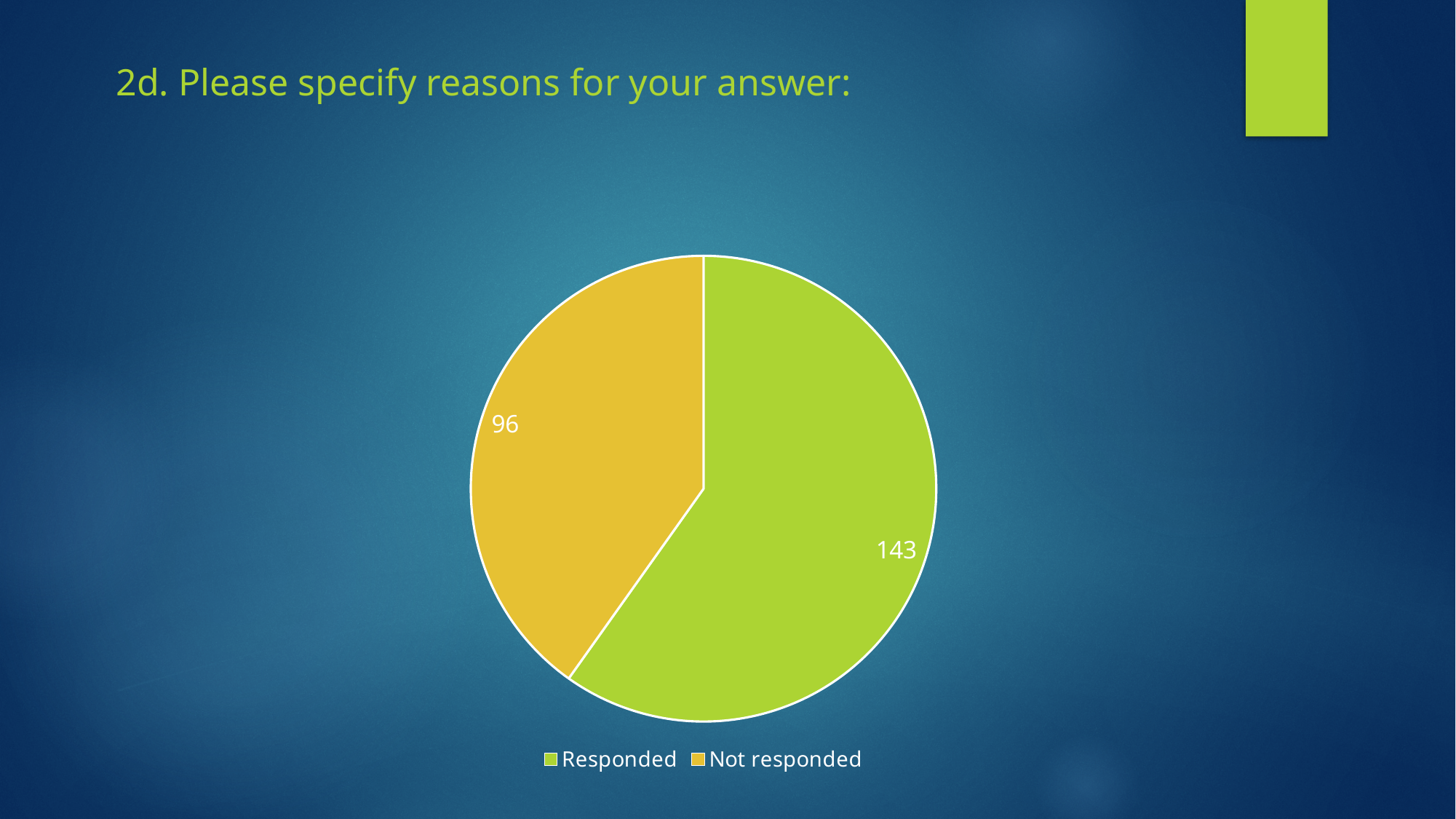
What is the value for Not responded? 96 Which is larger, Responded or Not responded? Responded What share of the pie does the Responded slice represent, to the nearest whole percent? 60% How many entries does the legend list? 2 What kind of chart is shown on the slide? pie chart Which category has the smallest slice of the pie? Not responded What is the difference between the Responded and Not responded values? 47 What is the value for Responded? 143 Which category has the largest slice of the pie? Responded What is the total of all slices in the pie chart? 239 What colour is the Not responded slice? gold How many slices does the pie chart have? 2